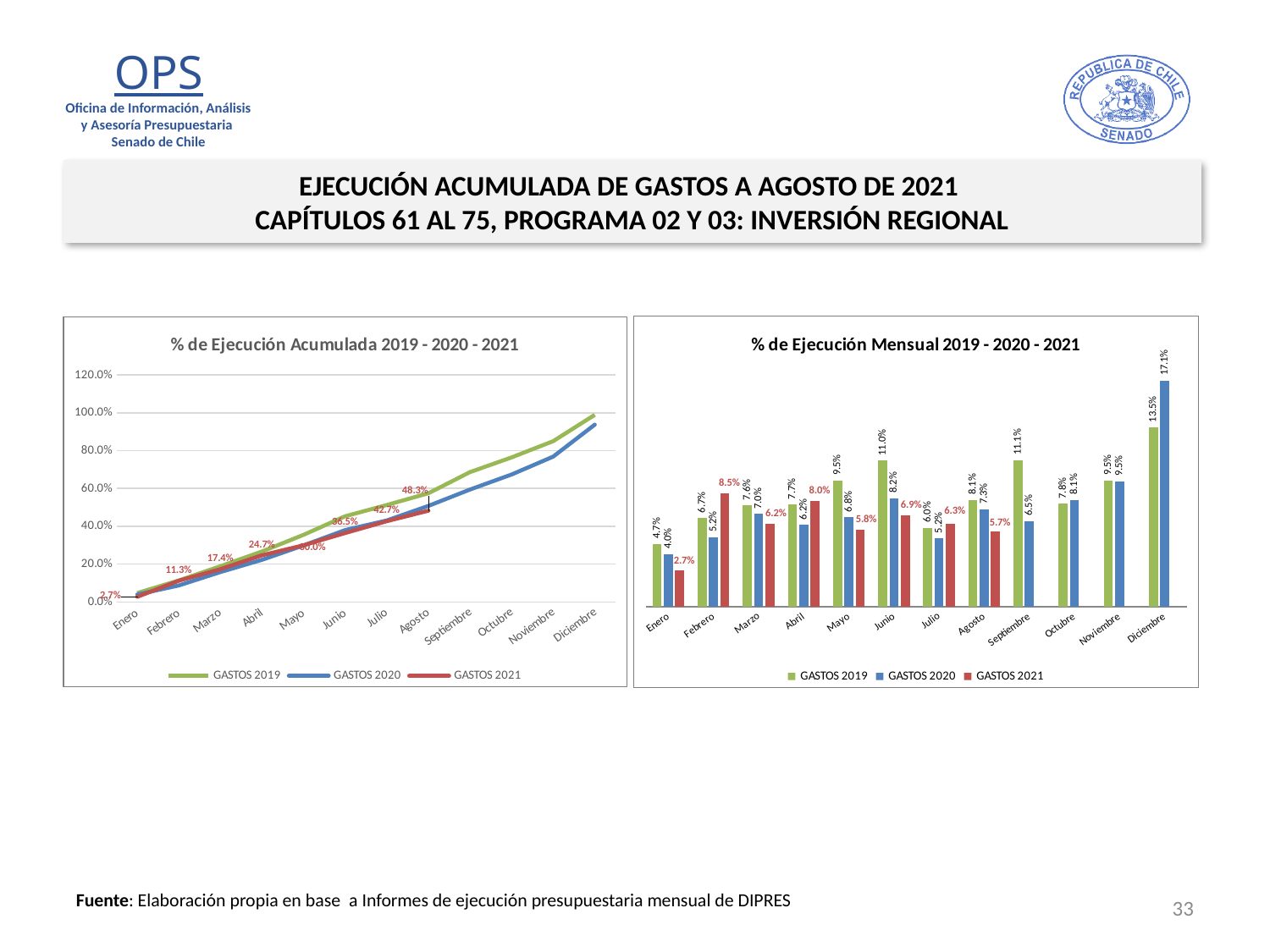
On the right chart (% de Ejecución Mensual), what is the difference between the GASTOS 2020 and GASTOS 2019 values in Diciembre? 3.6 percentage points How many series does the legend of the left chart (% de Ejecución Acumulada) list? 3 On the left chart (% de Ejecución Acumulada), is the GASTOS 2019 value in Diciembre greater or less than 80.0%? greater On the right chart (% de Ejecución Mensual), in which month is the GASTOS 2021 value lowest? Enero On the right chart (% de Ejecución Mensual), in which month is the GASTOS 2019 value highest? Diciembre On the right chart (% de Ejecución Mensual), what is the value for GASTOS 2021 in Febrero? 8.5% What kind of chart is the left chart (% de Ejecución Acumulada)? Line chart On the right chart (% de Ejecución Mensual), what is the value for GASTOS 2020 in Diciembre? 17.1% On the right chart (% de Ejecución Mensual), which is larger in Junio: GASTOS 2019 or GASTOS 2020? GASTOS 2019 On the left chart (% de Ejecución Acumulada), what is the value for GASTOS 2021 in Agosto? 48.3% On the left chart (% de Ejecución Acumulada), do the GASTOS 2021 values rise or fall from Enero to Agosto? Rise On the left chart (% de Ejecución Acumulada), what is the value for GASTOS 2021 in Abril? 24.7%